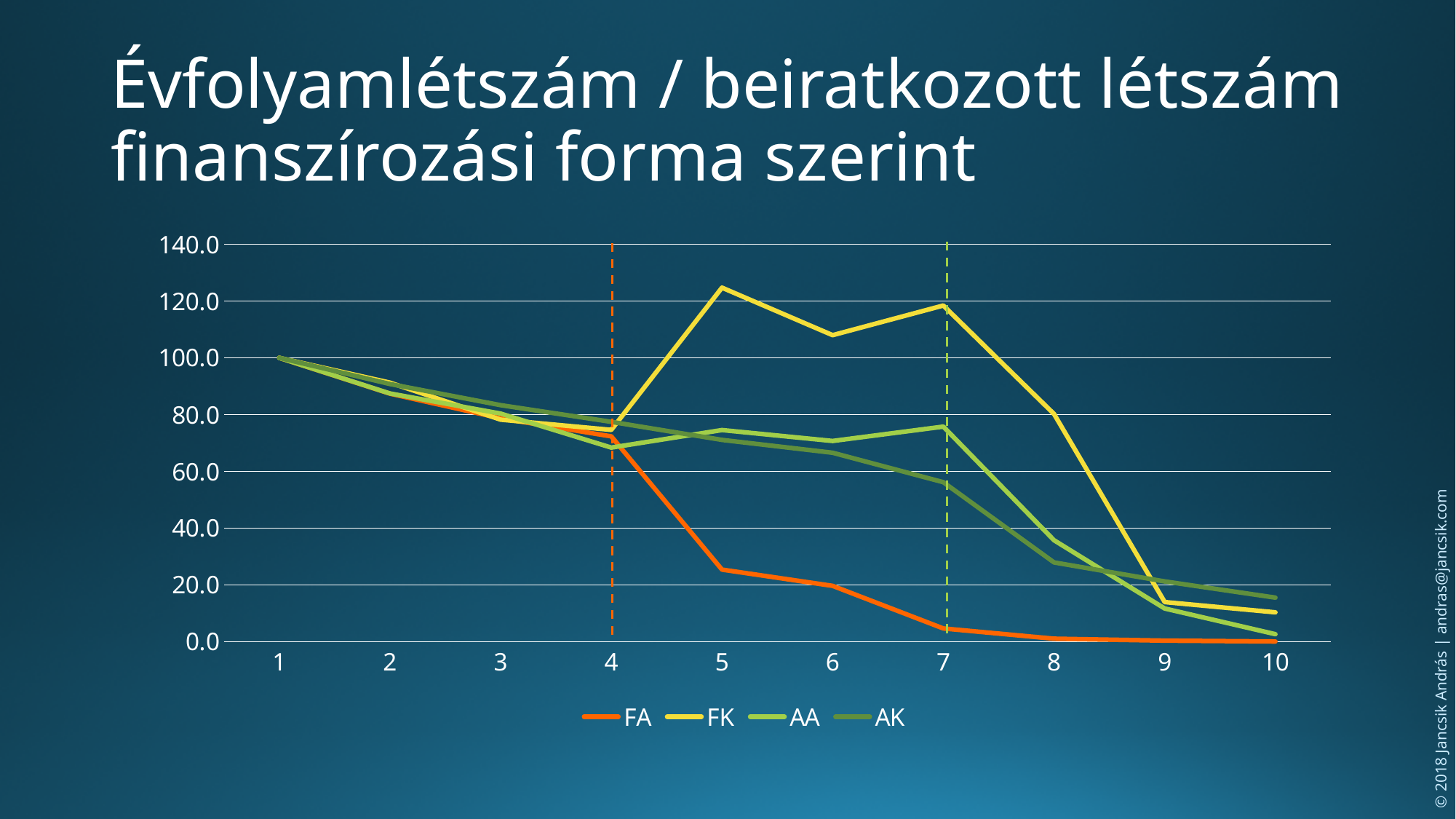
At x = 7, which series has the larger value, AA or AK? AA What is the value of the FA series at x = 1? 100.0 Which series has the highest value at x = 5? FK How many series does the legend list? 4 Is the value of FA at x = 5 greater or less than 40? less What kind of chart is shown on the slide? line chart Which series has the lowest value at x = 6? FA Is the value of AA at x = 10 greater or less than 20? less How many points are there along the x axis? 10 Does the FA series rise or fall along the x axis? fall Which series is drawn in orange? FA Is the value of FK at x = 5 greater or less than 120? greater